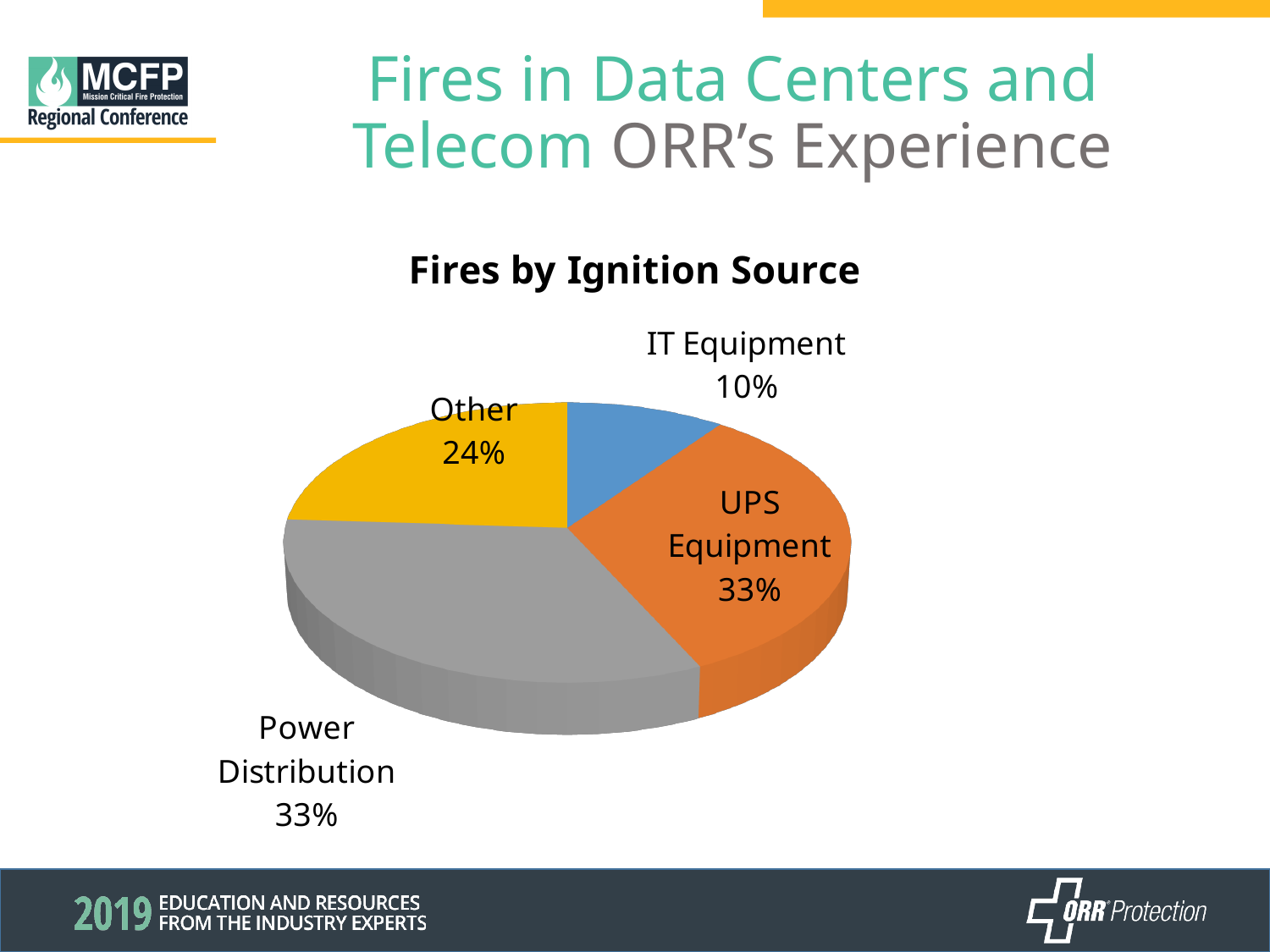
What colour is the Power Distribution slice? Grey How many ignition source categories are shown in the pie chart? 4 Which is larger, the share for Other or the share for IT Equipment? Other What share of fires is attributed to IT Equipment? 10% What share of fires is attributed to Other? 24% What share of fires is attributed to Power Distribution? 33% What is the difference in percentage points between the Other slice and the IT Equipment slice? 14 What kind of chart is shown on the slide? Pie chart What is the title of the chart? Fires by Ignition Source What is the difference in percentage points between the UPS Equipment slice and the Other slice? 9 What share of fires is attributed to UPS Equipment? 33% Which ignition source has the smallest share of fires? IT Equipment